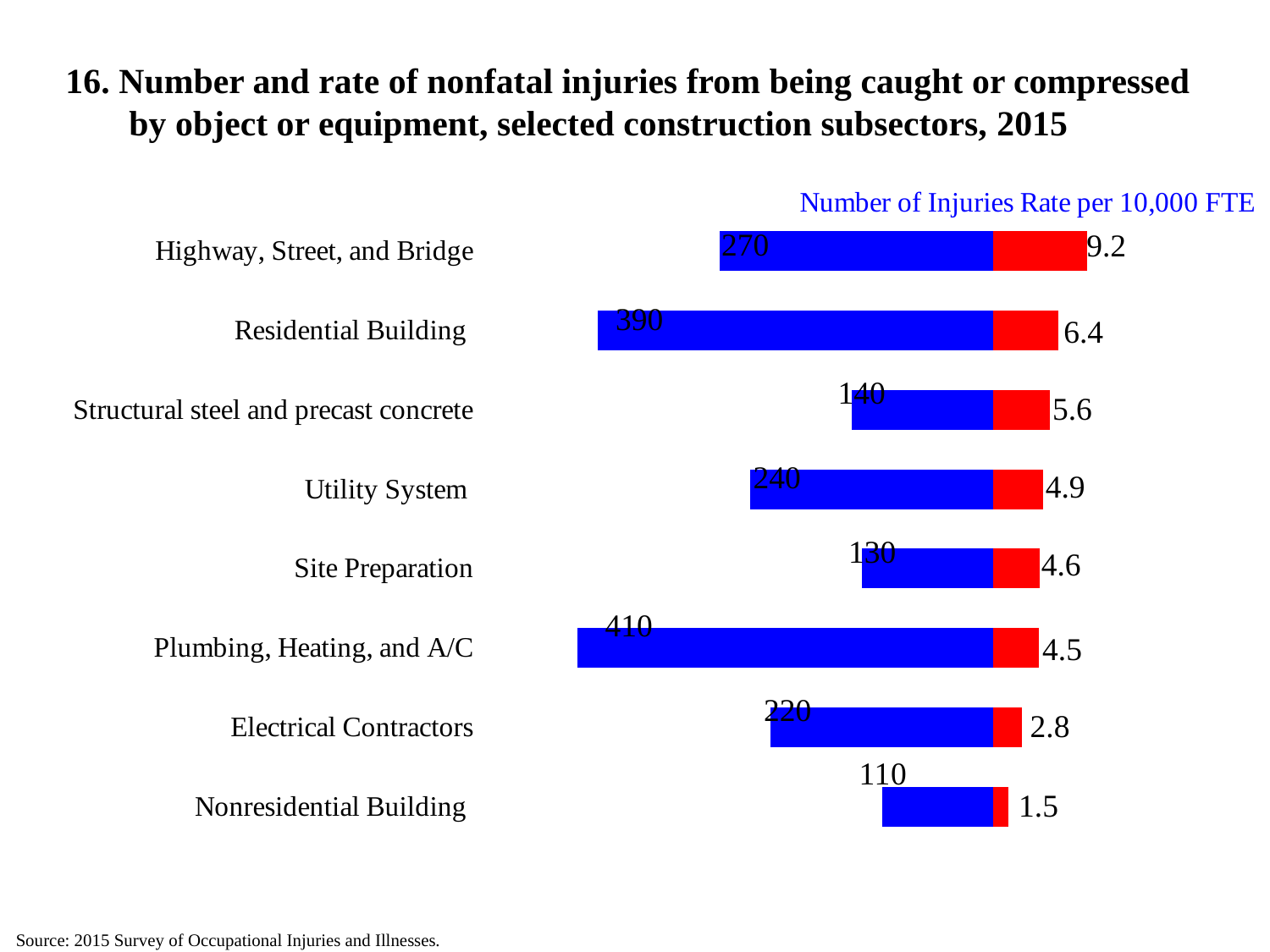
Which subsector has the lowest rate per 10,000 FTE? Nonresidential Building How many construction subsectors are shown in the chart? 8 Which subsector has the highest number of injuries? Plumbing, Heating, and A/C What is the difference in number of injuries between Residential Building and Utility System? 150 What is the rate per 10,000 FTE for Structural steel and precast concrete? 5.6 What is the rate per 10,000 FTE for Highway, Street, and Bridge? 9.2 What is the difference in rate per 10,000 FTE between Highway, Street, and Bridge and Electrical Contractors? 6.4 Which has a higher number of injuries, Site Preparation or Electrical Contractors? Electrical Contractors What is the number of injuries for Nonresidential Building? 110 What type of chart is shown on the slide? Bar chart What is the number of injuries for Plumbing, Heating, and A/C? 410